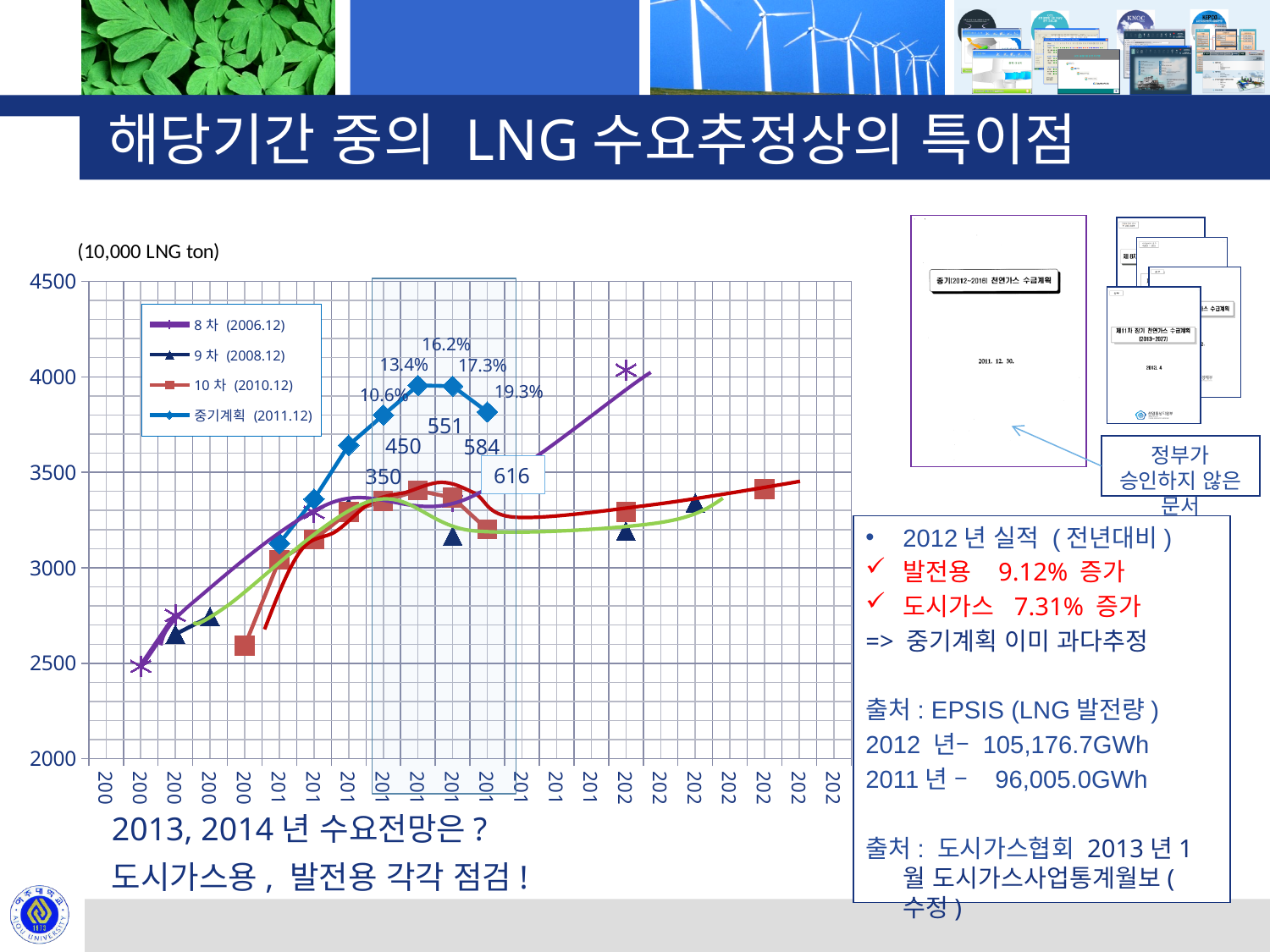
What is the smallest percentage label printed on the chart? 10.6% Is the first plotted point of the 10차 (2010.12) series greater or less than 3000? less Is the peak value of the 중기계획 (2011.12) series greater or less than 3500? greater What unit is stated above the chart's y axis? (10,000 LNG ton) What is the lowest value shown on the chart's y axis? 2000 Does the 중기계획 (2011.12) series rise or fall after reaching its peak? fall What is the largest percentage label printed on the chart? 19.3% How many percentage labels are printed on the chart? 5 What is the highest value shown on the chart's y axis? 4500 What kind of chart is shown on the slide? line chart How many series does the chart legend list? 4 Which series in the legend is dated 2011.12? 중기계획